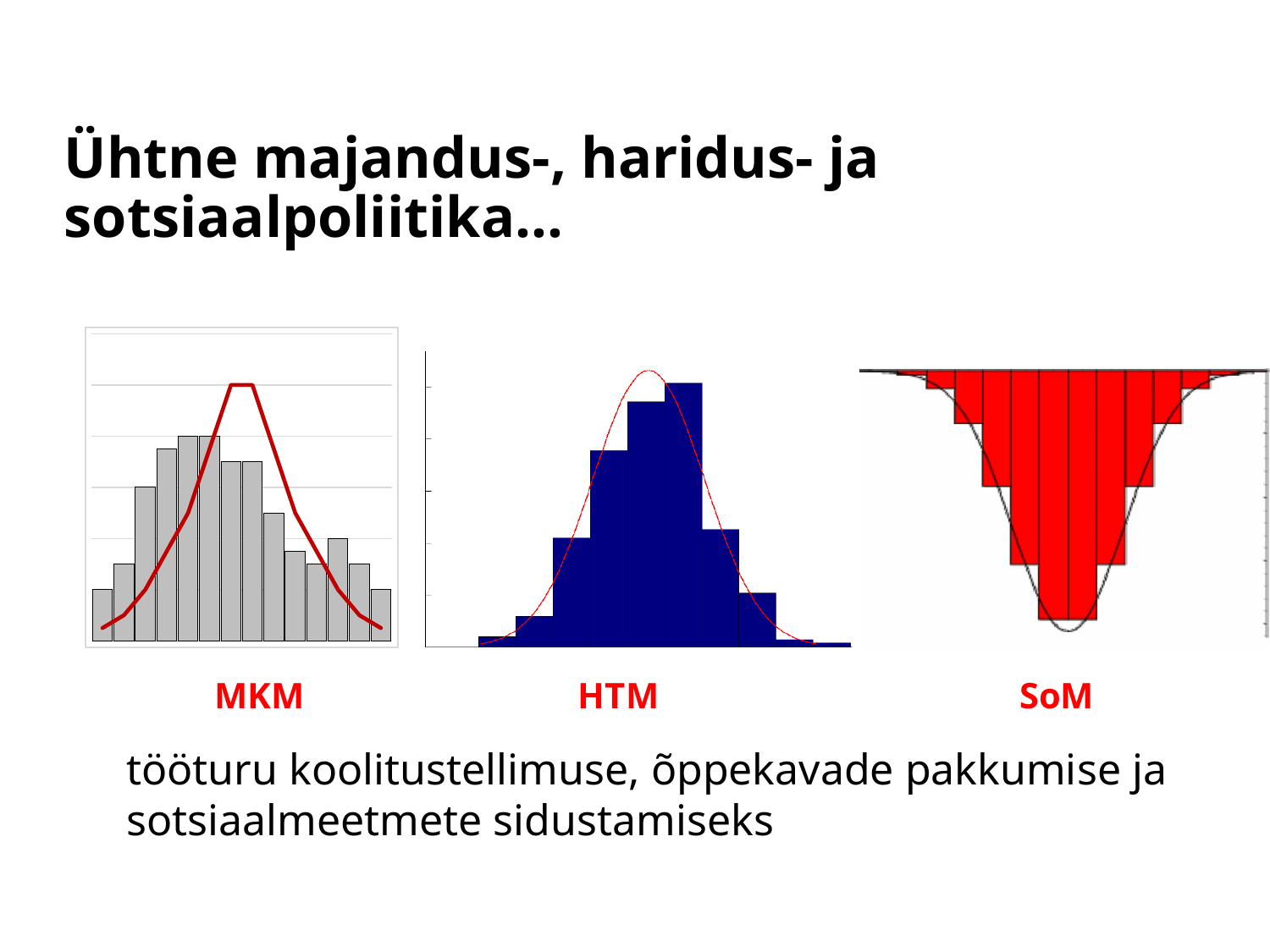
In the HTM chart, what colour are the bars? blue In the MKM chart, do the bar heights rise or fall across the first five bars from the left? rise In the HTM chart, do the bar heights rise or fall from the tallest bar toward the right edge? fall How many charts are shown on the slide? 3 In the SoM chart, do the bar lengths increase or decrease from the centre toward the right edge? decrease What kind of chart is the MKM chart? bar and line chart What kind of chart is the HTM chart? bar chart What kind of chart is the SoM chart? bar chart